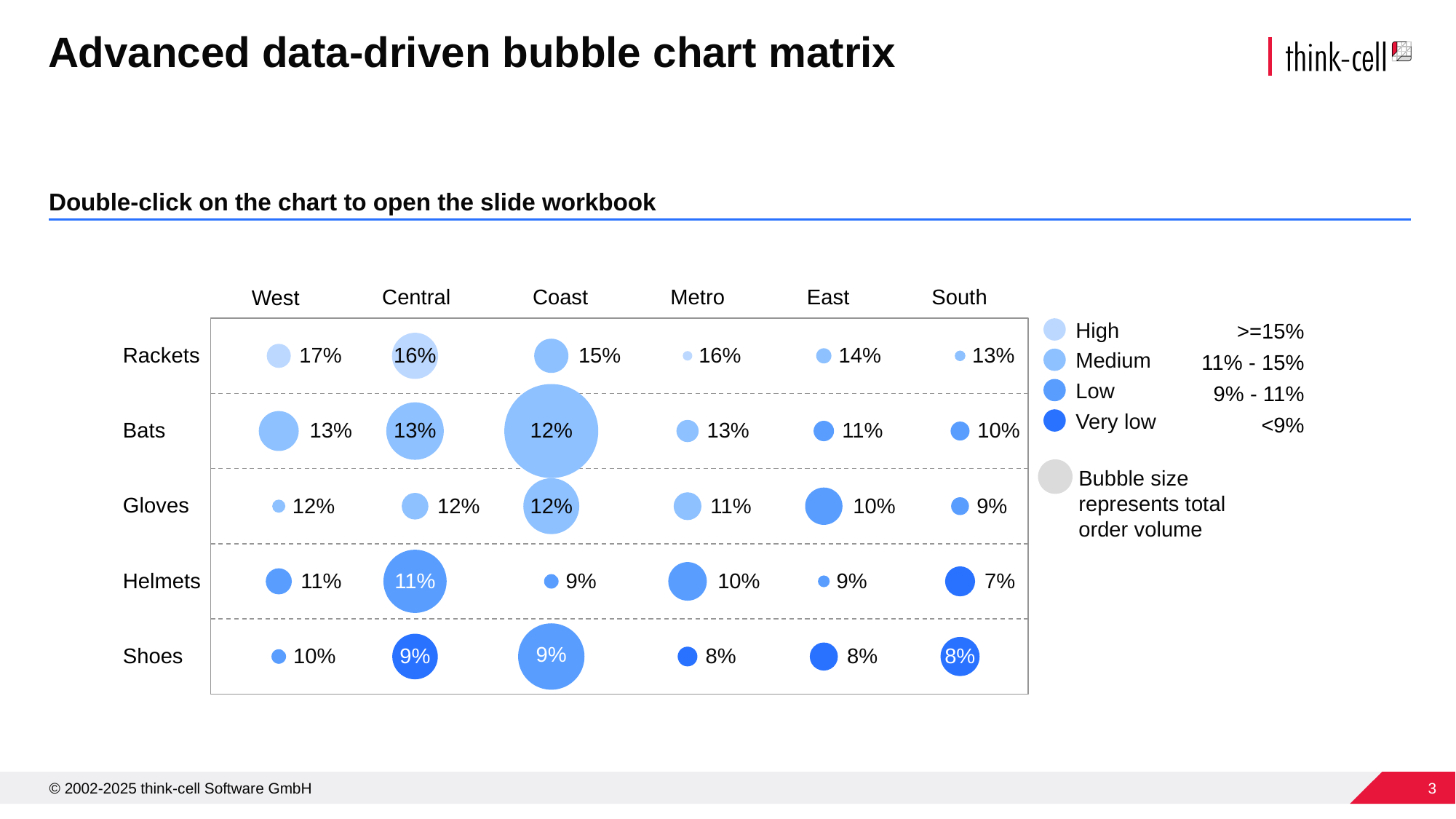
Which is larger: the Gloves value in East or the Gloves value in South? East What is the value for Rackets in the West region? 17% Which region has the highest value for Rackets? West How many regions are shown as columns in the matrix? 6 How many product rows are shown in the matrix? 5 What is the difference between the Rackets value in West and the Rackets value in South? 4% What is the value for Bats in the Coast region? 12% Which region has the lowest value for Helmets? South What kind of chart is shown on the slide? Bubble chart According to the legend, what does the bubble size represent? Total order volume What is the value for Helmets in the South region? 7% What is the value for Shoes in the Central region? 9%